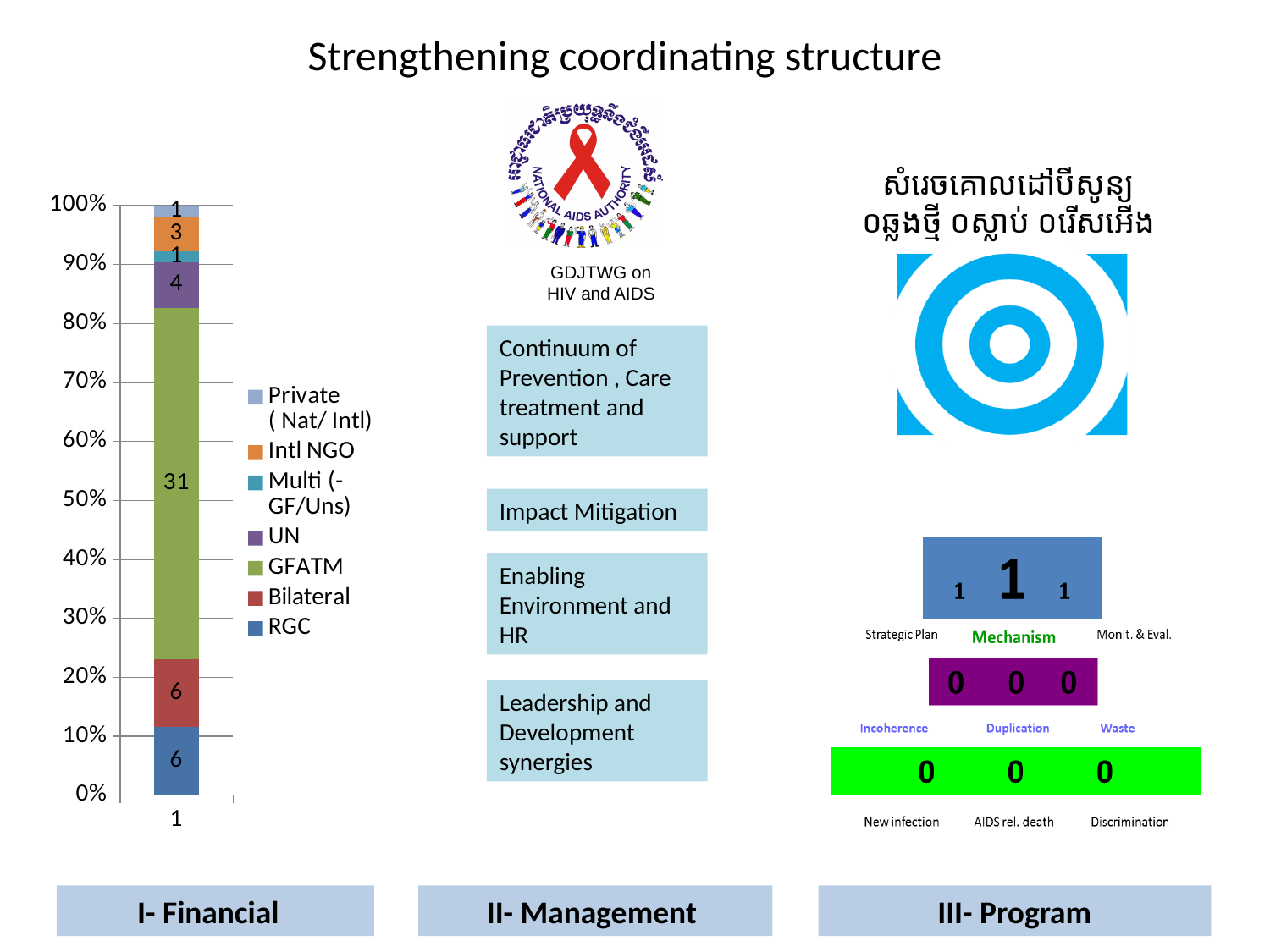
What value is shown for the GFATM segment in the stacked bar? 31 How many series does the chart legend list? 7 What is the difference between the GFATM value and the UN value? 27 Which is larger, the UN segment or the Intl NGO segment? UN How many bars are plotted in the chart? 1 What is the total of all segments in the stacked bar? 52 What value is shown for the Bilateral segment in the stacked bar? 6 Which series has the largest segment in the stacked bar? GFATM What kind of chart is shown in the Financial section? Stacked bar chart What value is shown for the UN segment in the stacked bar? 4 What value is shown for the Intl NGO segment in the stacked bar? 3 What value is shown for the RGC segment in the stacked bar? 6